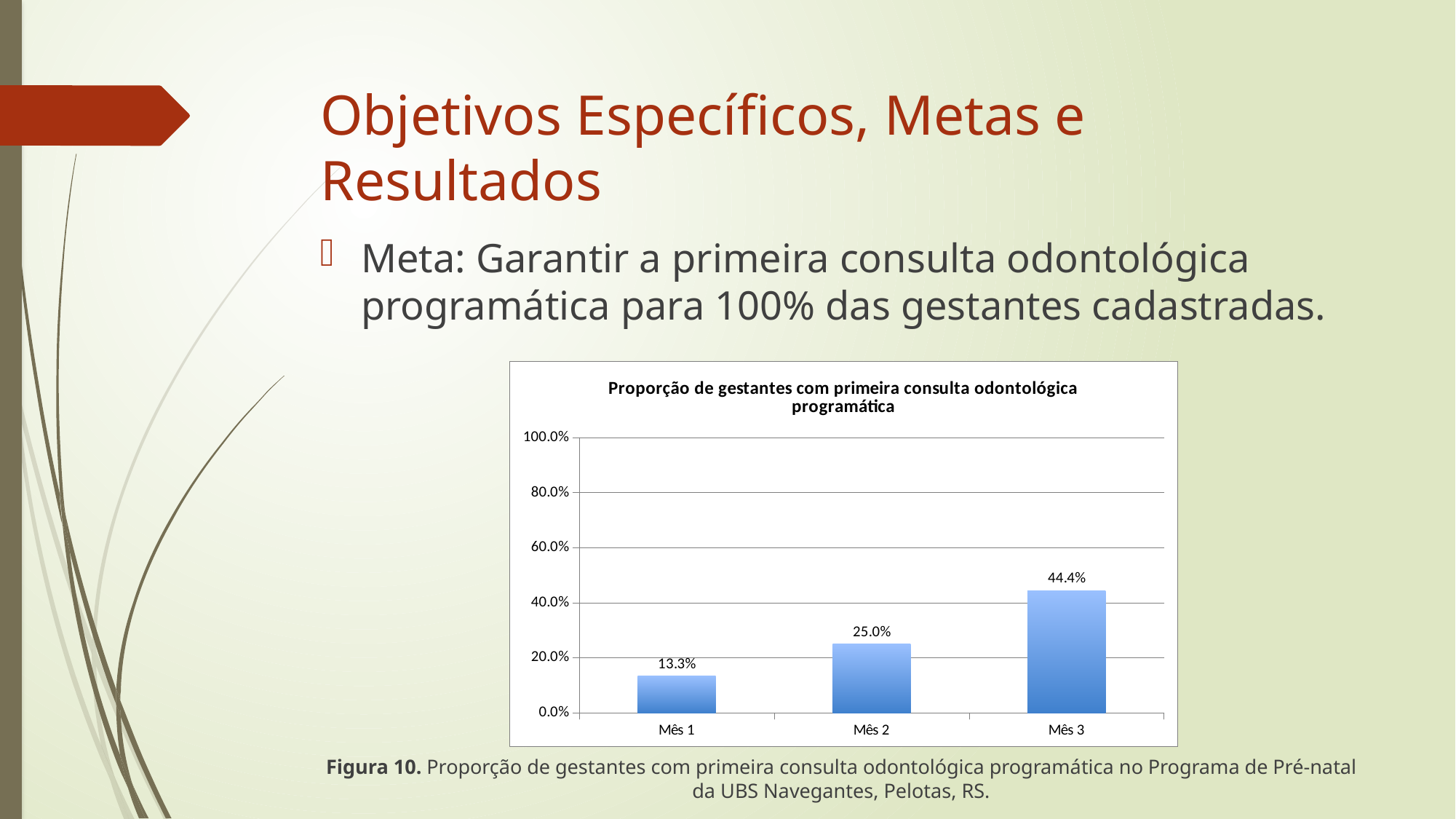
What is the value for Mês 2? 25.0% Is the value for Mês 3 greater or less than 40.0%? greater What is the difference between the values for Mês 3 and Mês 2? 19.4% Which month has the highest proportion? Mês 3 Which is larger, the value for Mês 1 or the value for Mês 2? Mês 2 What is the value for Mês 1? 13.3% Do the values rise or fall from Mês 1 to Mês 3? rise What is the value for Mês 3? 44.4% What kind of chart is shown on the slide? bar chart What is the difference between the values for Mês 2 and Mês 1? 11.7% How many months are shown on the x axis? 3 Which month has the lowest proportion? Mês 1